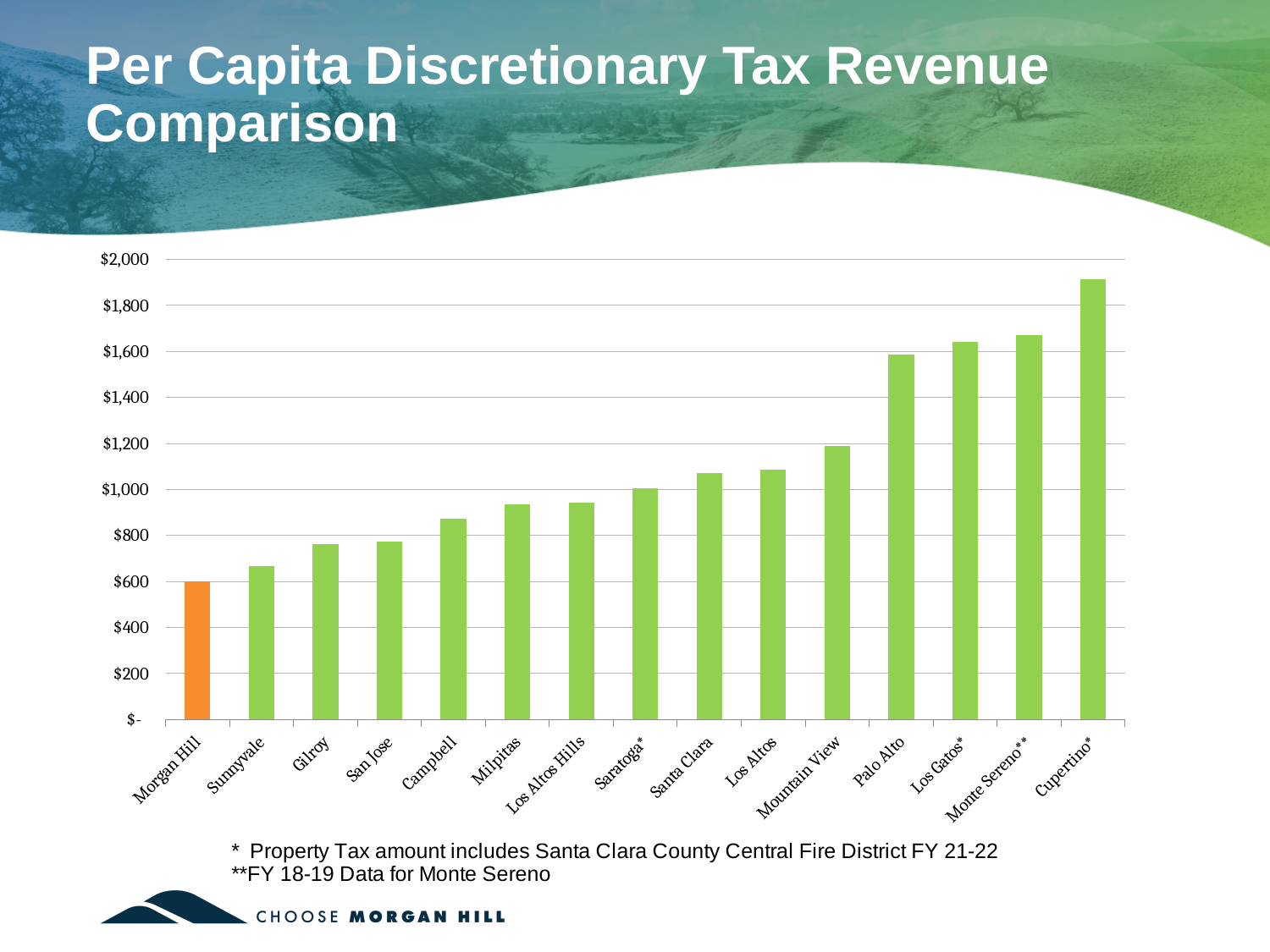
Is the value for Campbell greater or less than $800? greater Do the bar values rise or fall from left to right along the x axis? rise Which city's bar is coloured orange instead of green? Morgan Hill Which is larger, the value for Palo Alto or the value for Mountain View? Palo Alto Is the value for Sunnyvale greater or less than $800? less How many cities are shown on the x axis? 15 Which is larger, the value for Gilroy or the value for Milpitas? Milpitas Which city has the highest per capita discretionary tax revenue? Cupertino* Is the value for Cupertino* greater or less than $1,800? greater What kind of chart is shown on the slide? bar chart Which city has the lowest per capita discretionary tax revenue? Morgan Hill